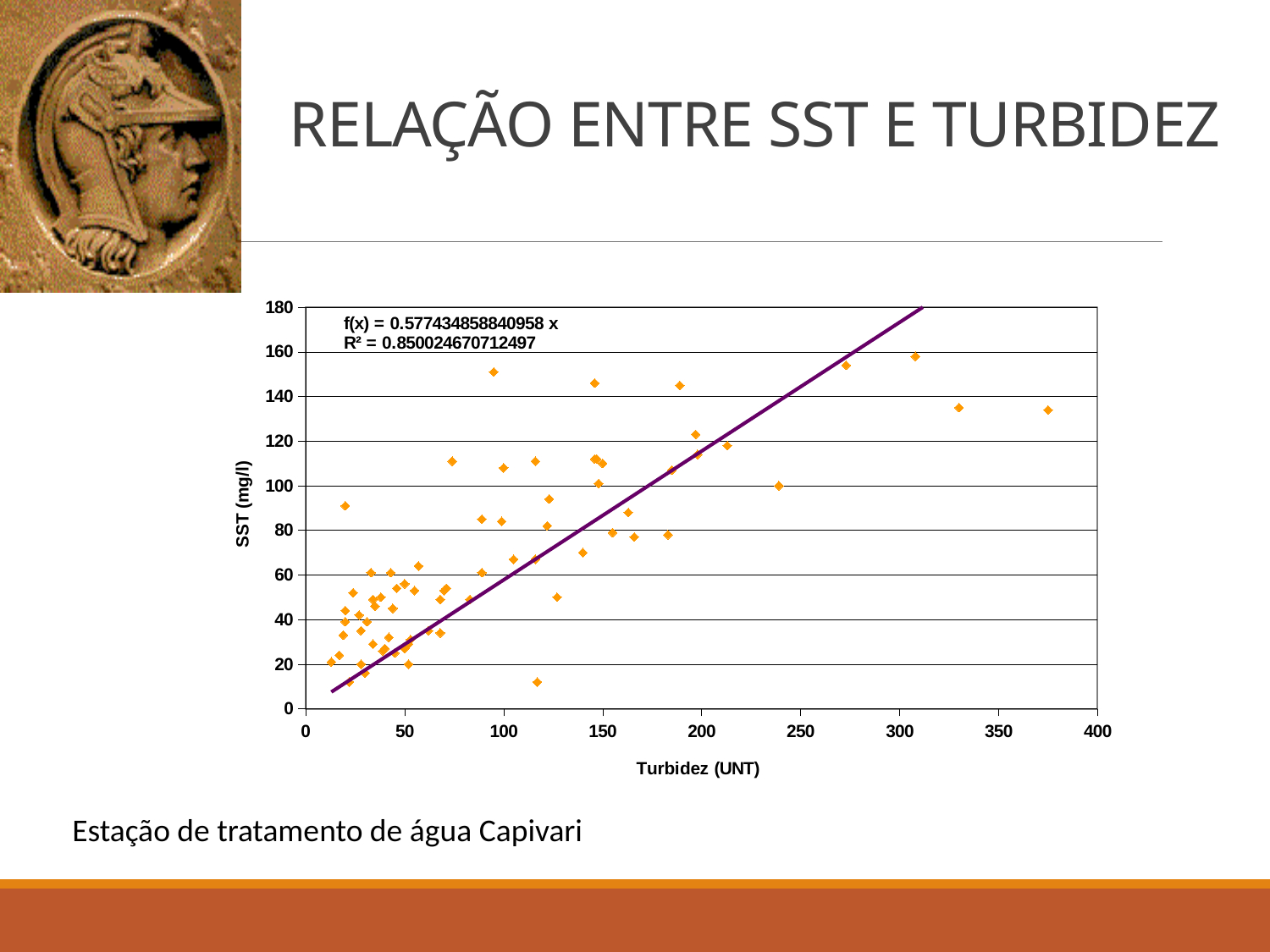
What is the label of the y axis of the chart? SST (mg/l) What is the maximum value shown on the y axis of the chart? 180 What R² value is printed on the chart? 0.850024670712497 Is the lowest SST value plotted on the chart greater or less than 20? less Do the SST values generally rise or fall as turbidity increases along the x axis? Rise What is the maximum value shown on the x axis of the chart? 400 What is the label of the x axis of the chart? Turbidez (UNT) What is the title of the chart on the slide? RELAÇÃO ENTRE SST E TURBIDEZ What kind of chart is shown on the slide? Scatter plot Is the highest SST value plotted on the chart greater or less than 140? greater Is the SST value of the point with the highest turbidity (around 375 UNT) greater or less than 120? greater What is the equation of the trendline shown on the chart? f(x) = 0.577434858840958 x